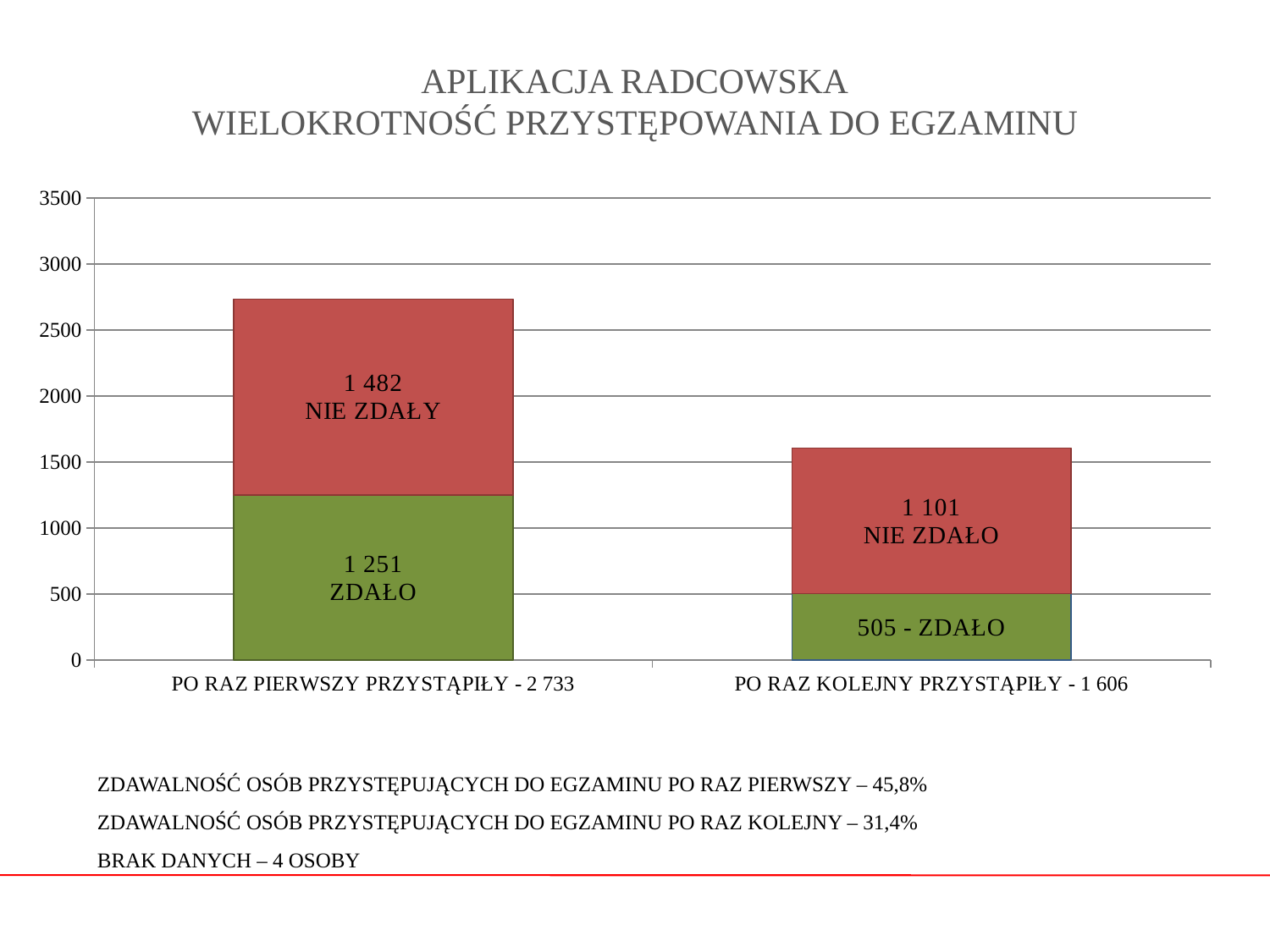
How many people passed (ZDAŁO) among those who took the exam again (PO RAZ KOLEJNY PRZYSTĄPIŁY)? 505 How many people did not pass (NIE ZDAŁO) among those who took the exam again? 1 101 Which is larger: the number who passed on the first attempt or the number who passed on a repeat attempt? first attempt (1 251) What is the difference between the number who did not pass on the first attempt (1 482) and the number who did not pass on a repeat attempt (1 101)? 381 What is the total height of the bar for PO RAZ PIERWSZY PRZYSTĄPIŁY? 2 733 How many people did not pass (NIE ZDAŁY) among those who took the exam for the first time? 1 482 How many categories (bars) does the chart show? 2 How many people passed (ZDAŁO) among those who took the exam for the first time (PO RAZ PIERWSZY PRZYSTĄPIŁY)? 1 251 Which colour represents the people who passed (ZDAŁO) in the chart? green What is the total height of the bar for PO RAZ KOLEJNY PRZYSTĄPIŁY? 1 606 What kind of chart is shown on the slide? stacked bar chart Which category has the taller bar in total? PO RAZ PIERWSZY PRZYSTĄPIŁY